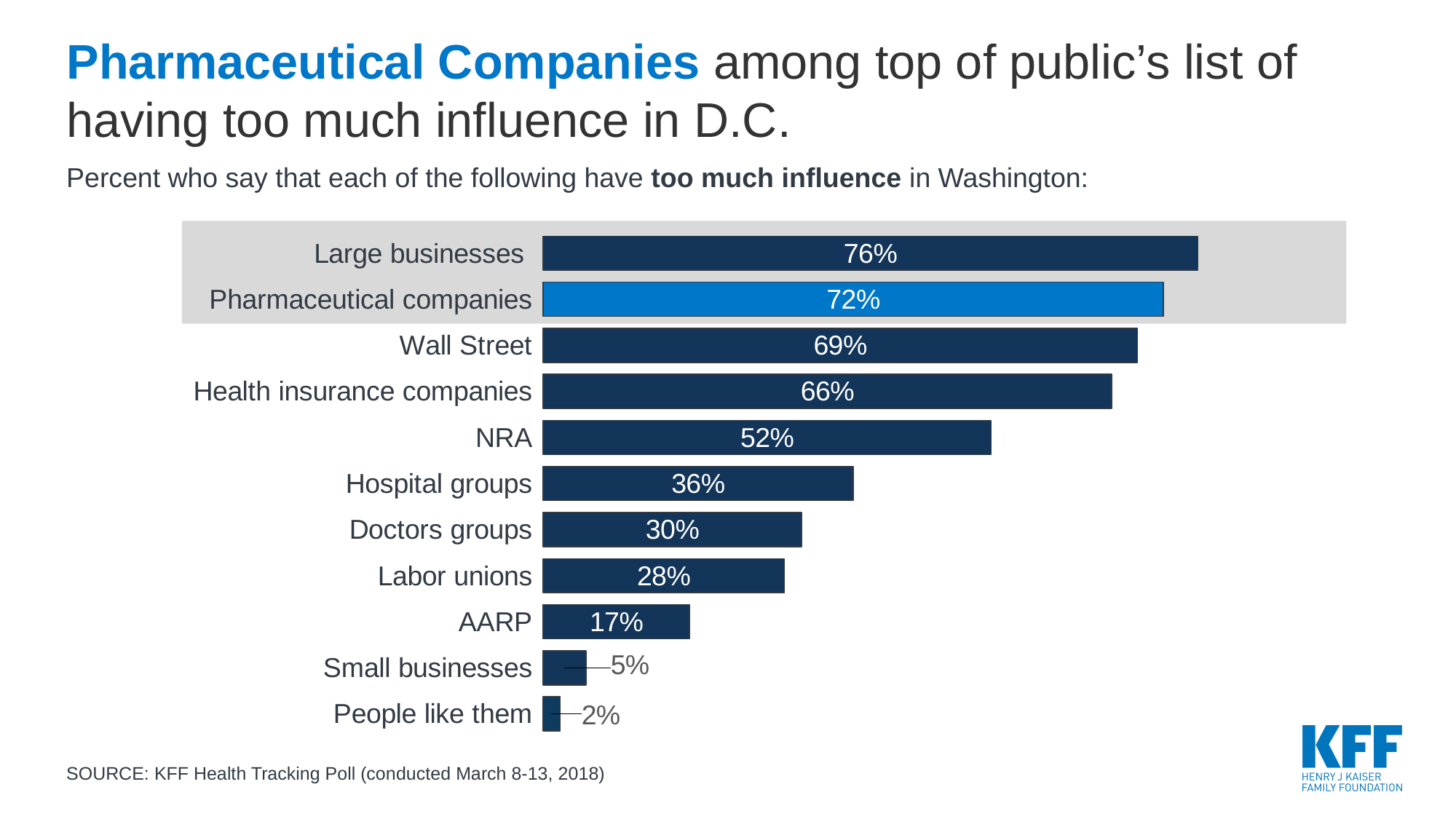
Which has a higher value, AARP or small businesses? AARP How many categories are shown on the chart? 11 Which category has the lowest value on the chart? People like them What percent say pharmaceutical companies have too much influence in Washington? 72% Which has a higher value, Wall Street or health insurance companies? Wall Street Which category has the highest value on the chart? Large businesses What is the difference between the values for hospital groups and doctors groups? 6 percentage points Which bar is highlighted in a lighter blue colour than the others? Pharmaceutical companies What kind of chart is shown on the slide? Bar chart What is the difference between the values for large businesses and pharmaceutical companies? 4 percentage points What percent say labor unions have too much influence? 28% What is the value shown for the NRA? 52%